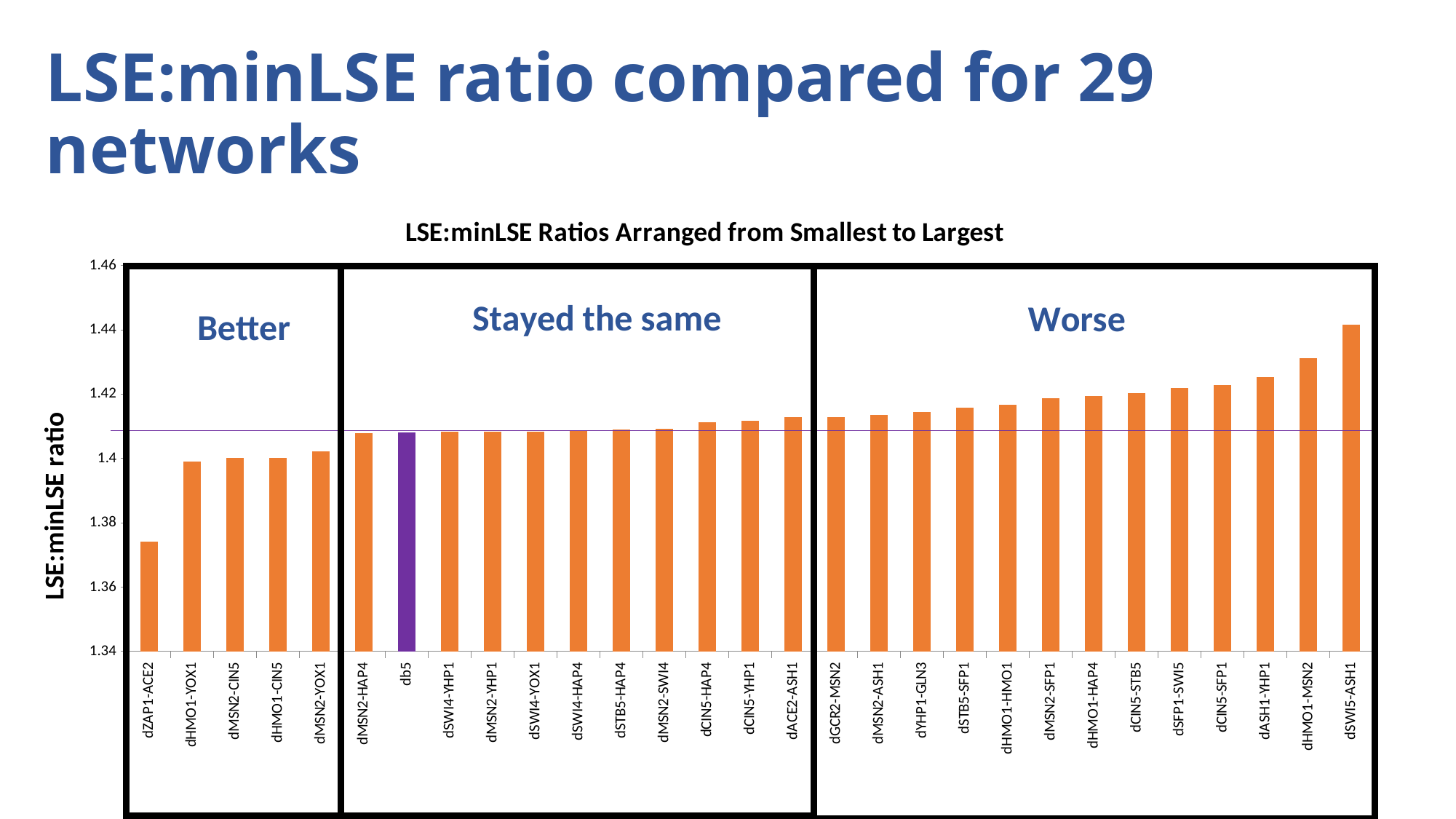
Which network has the lowest LSE:minLSE ratio? dZAP1-ACE2 Is the LSE:minLSE ratio for dZAP1-ACE2 greater or less than 1.38? less Is the LSE:minLSE ratio for dHMO1-MSN2 greater or less than 1.42? greater What kind of chart is shown on the slide? Bar chart Which network's bar is coloured purple instead of orange? db5 How many bars are in the group labelled "Better"? 5 How many networks (bars) are plotted in the chart? 29 Which network has the highest LSE:minLSE ratio? dSWI5-ASH1 Do the LSE:minLSE ratios rise or fall from left to right along the x axis? Rise Which has the larger LSE:minLSE ratio, dHMO1-MSN2 or dASH1-YHP1? dHMO1-MSN2